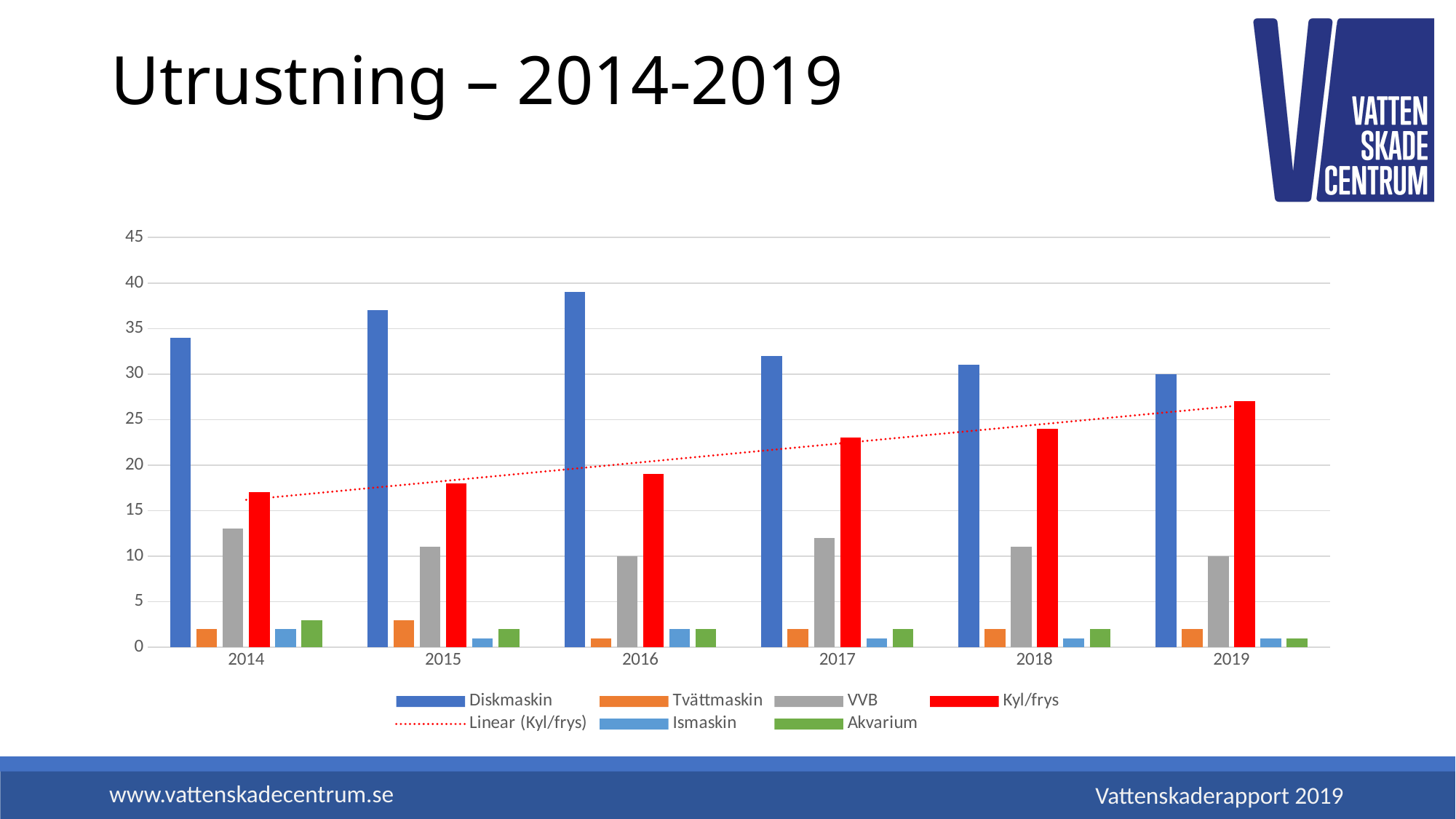
What kind of chart is shown on the slide? bar chart In 2019, which is larger: Diskmaskin or Kyl/frys? Diskmaskin In which year is the Kyl/frys bar highest? 2019 How many entries does the chart's legend list? 7 What does the dotted line in the chart represent, according to the legend? Linear (Kyl/frys) What colour are the Kyl/frys bars? red How many years are shown on the x axis of the chart? 6 In which year is the Diskmaskin bar highest? 2016 Do the Kyl/frys values rise or fall from 2014 to 2019? rise Is the Diskmaskin value for 2014 greater or less than 30? greater Is the Kyl/frys value for 2017 greater or less than 20? greater In which year is the Diskmaskin bar lowest? 2019